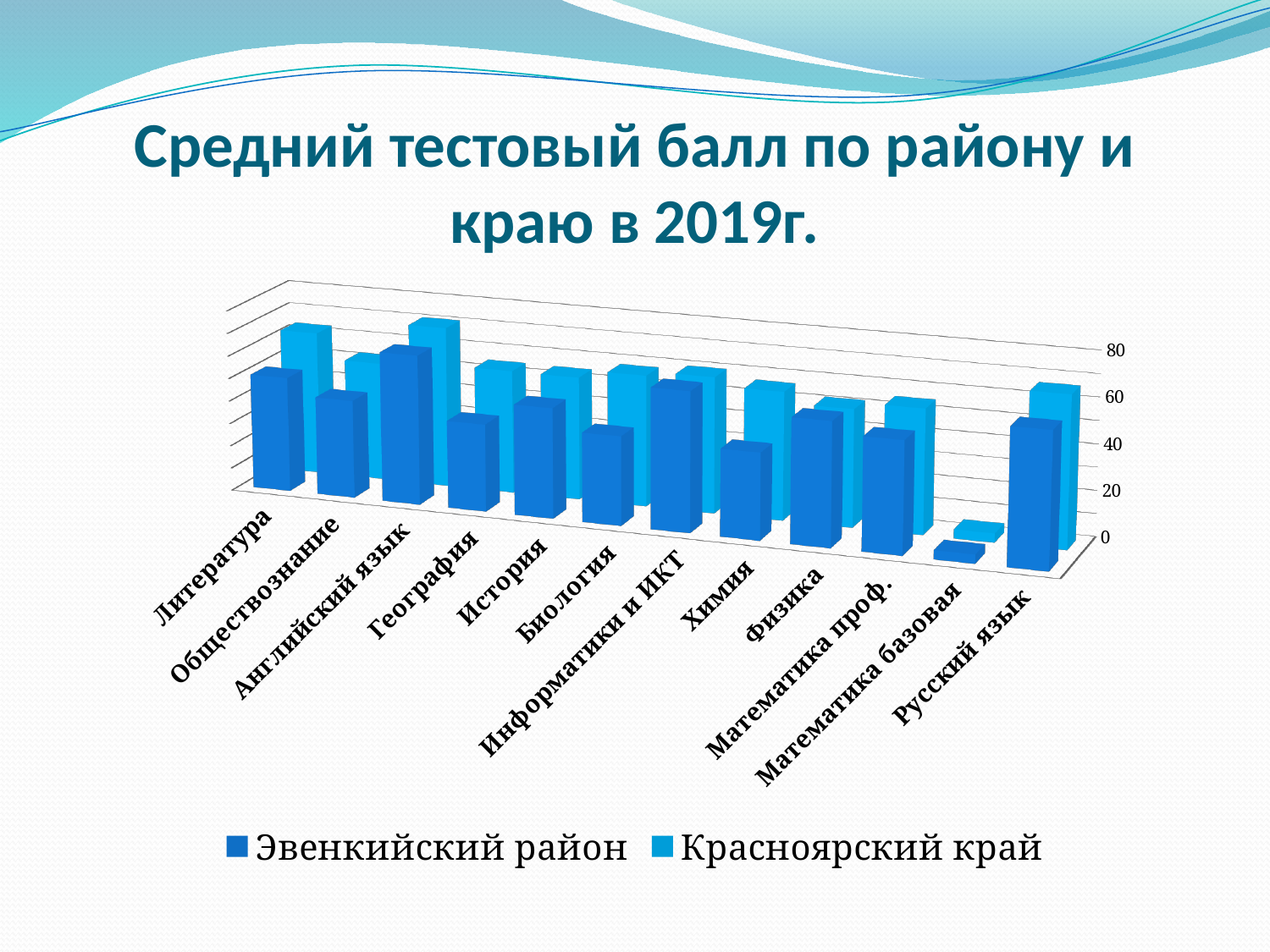
What is the title of the chart on the slide? Средний тестовый балл по району и краю в 2019г. How many series does the legend list? 2 Which two series are listed in the legend? Эвенкийский район and Красноярский край Is the value for Химия for Эвенкийский район greater or less than 60? less Which subject has the lowest value for Эвенкийский район? Математика базовая Is the value for Математика базовая for Эвенкийский район greater or less than 20? less For Биология, which series has the larger value: Эвенкийский район or Красноярский край? Красноярский край For Химия, which series has the larger value: Эвенкийский район or Красноярский край? Красноярский край How many subject categories are shown on the x axis? 12 What kind of chart is shown on the slide? bar chart Which subject has the lowest value for Красноярский край? Математика базовая